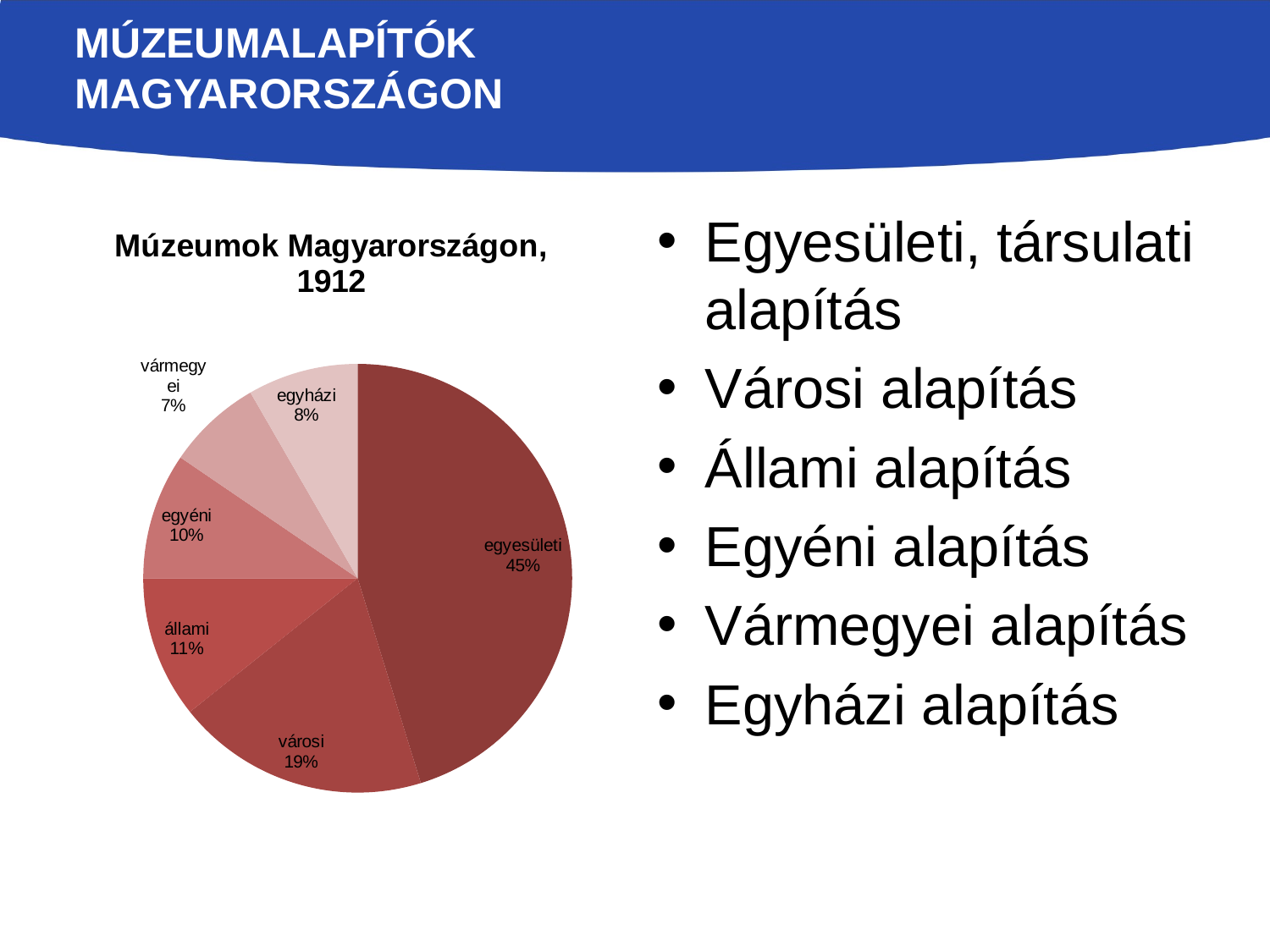
How many slices does the pie chart have? 6 What share of the pie does the 'egyesületi' slice represent? 45% What is the difference in percentage points between the 'egyesületi' and 'városi' slices? 26 What share of the pie does the 'vármegyei' slice represent? 7% What share of the pie does the 'városi' slice represent? 19% What is the title of the chart? Múzeumok Magyarországon, 1912 What kind of chart is shown on the slide? pie chart Which category has the largest slice of the pie? egyesületi Which category has the smallest slice of the pie? vármegyei